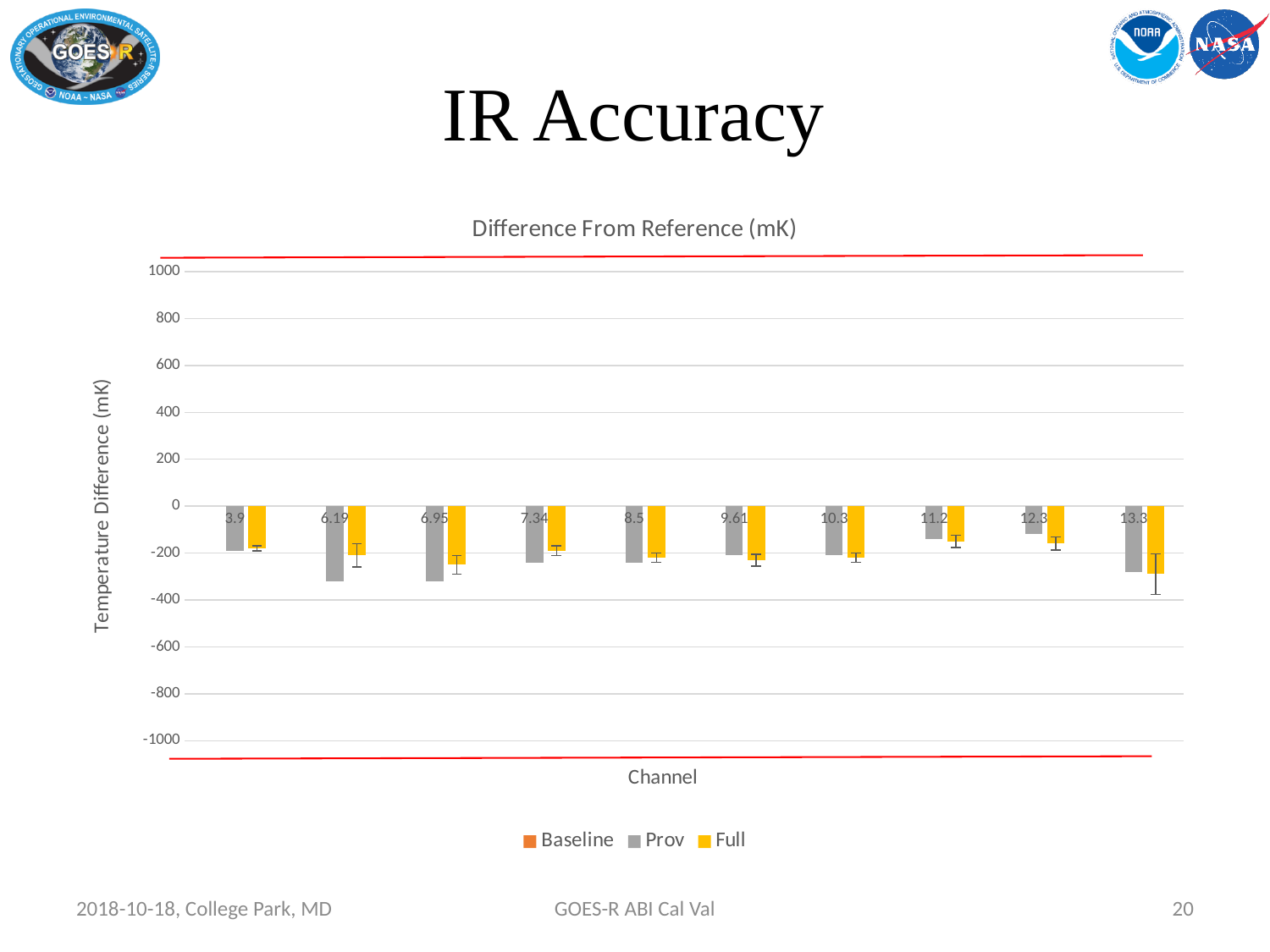
Is the Full value for channel 13.3 greater or less than -200? less Which is larger, the Prov value for channel 6.19 or the Prov value for channel 11.2? channel 11.2 What is the label of the y axis? Temperature Difference (mK) How many channel categories are shown on the x axis? 10 Are the Prov and Full values for all channels above or below zero? below Is the Prov value for channel 6.19 greater or less than -200? less Is the Full value for channel 12.3 greater or less than -200? greater What is the title of the chart? Difference From Reference (mK) What kind of chart is shown on the slide? bar chart How many series does the legend list? 3